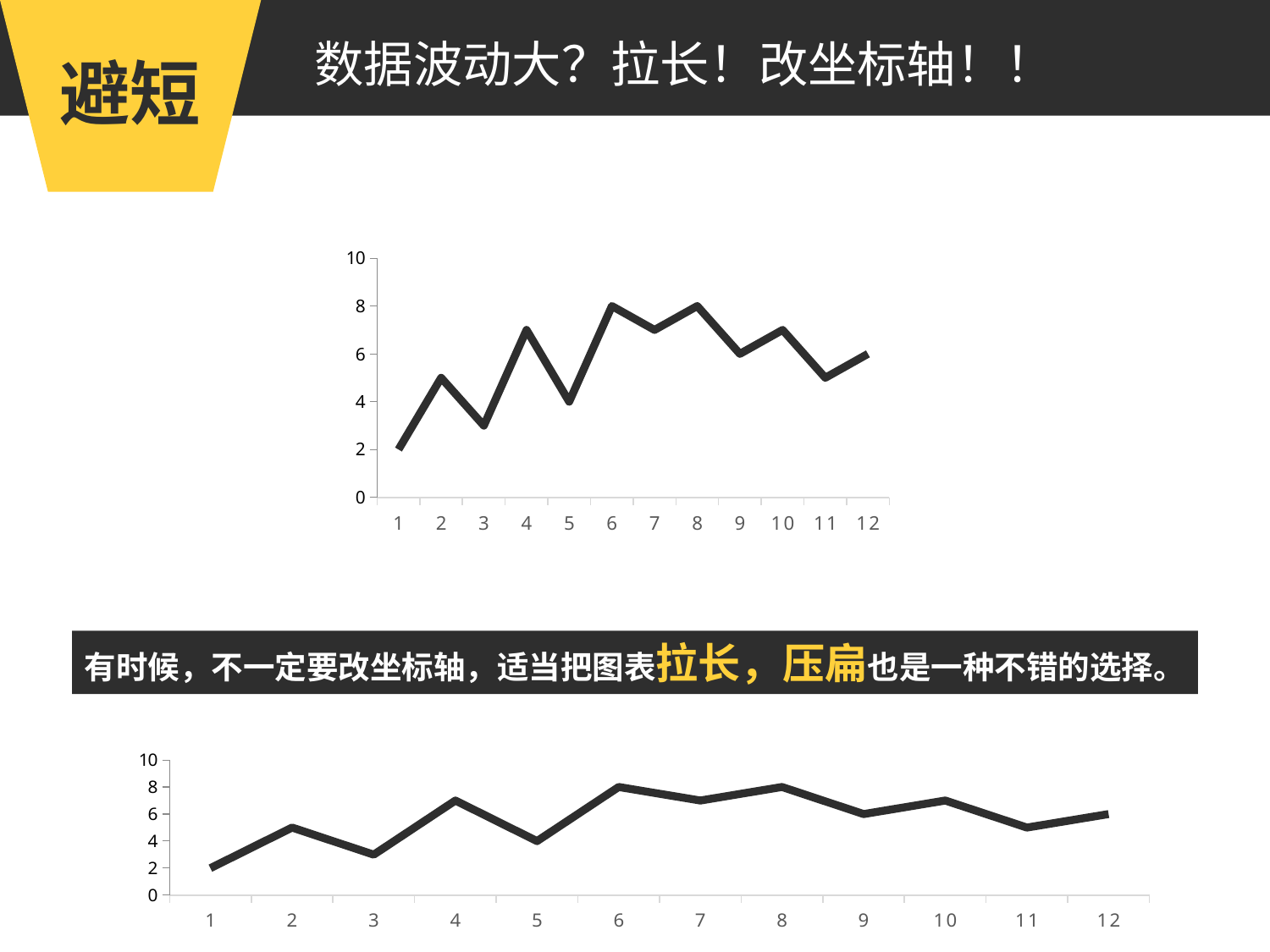
In the top chart, is the value at x = 4 greater or less than 6? greater In the top chart, which x value has the lowest point? 1 In the top chart, which is larger, the value at x = 2 or the value at x = 3? x = 2 In the bottom chart, what is the value at x = 9? 6 In the top chart, what is the value at x = 6? 8 In the bottom chart, is the value at x = 3 greater or less than 4? less In the bottom chart, what is the value at x = 12? 6 In the bottom chart, what is the difference between the value at x = 6 and the value at x = 1? 6 In the top chart, what is the value at x = 1? 2 In the bottom chart, is the value at x = 11 greater or less than 4? greater What kind of chart is the top chart on the slide? line chart How many points are plotted along the x axis of the bottom chart? 12